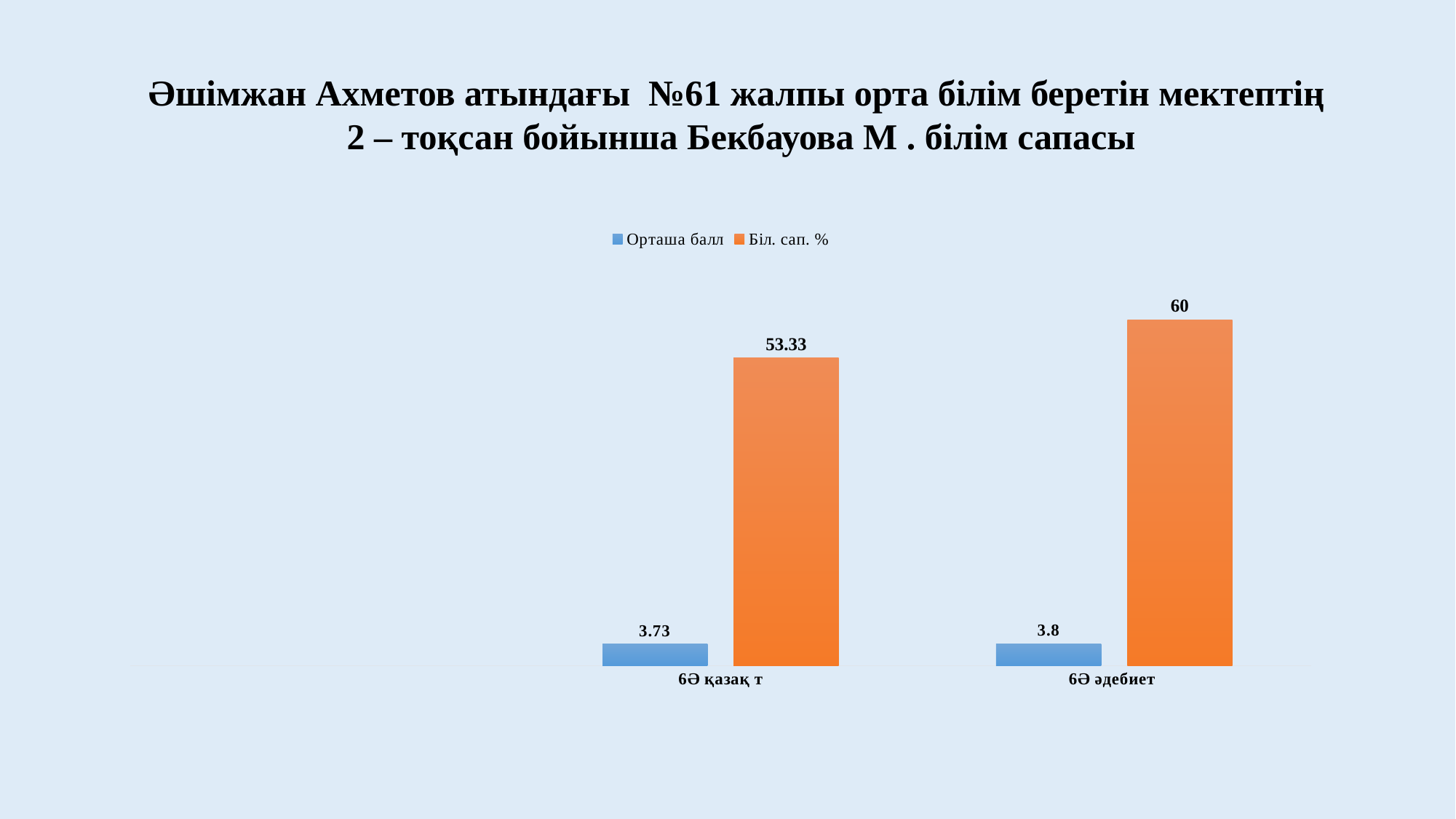
How many categories are shown on the x axis? 2 How many series does the legend list? 2 What is the difference between the Біл. сап. % values for 6Ә әдебиет and 6Ә қазақ т? 6.67 Which category has the lower Орташа балл value? 6Ә қазақ т Which colour represents the Біл. сап. % series in the legend? Orange What is the value of Біл. сап. % for 6Ә қазақ т? 53.33 What is the value of Орташа балл for 6Ә әдебиет? 3.8 Which is larger: Орташа балл for 6Ә әдебиет or Орташа балл for 6Ә қазақ т? 6Ә әдебиет What kind of chart is shown on the slide? Bar chart What is the value of Орташа балл for 6Ә қазақ т? 3.73 Which category has the higher Біл. сап. % value? 6Ә әдебиет What is the value of Біл. сап. % for 6Ә әдебиет? 60